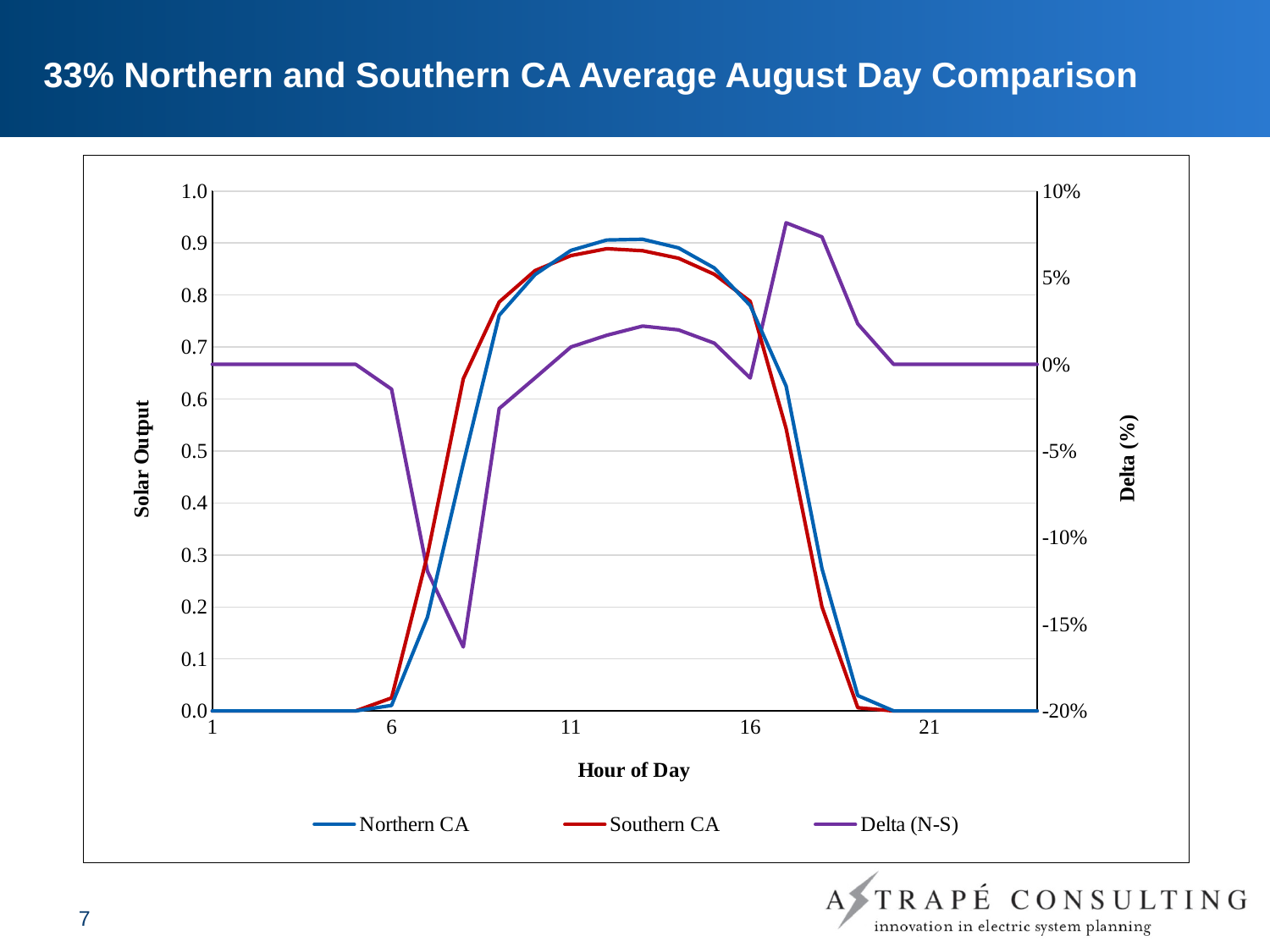
Is the Southern CA value at hour 6 greater or less than 0.1? less What is the label of the x axis? Hour of Day Does the Northern CA solar output rise or fall between hour 6 and hour 12? rise What are the three series named in the legend? Northern CA, Southern CA, Delta (N-S) Does the Southern CA solar output rise or fall between hour 14 and hour 19? fall How many series does the legend list? 3 Is the Delta (N-S) value at hour 17 greater or less than 5%? greater Is the Northern CA value at hour 12 greater or less than 0.8? greater At hour 8, which series has the higher solar output, Northern CA or Southern CA? Southern CA What kind of chart is shown on the slide? Line chart At hour 17, which series has the higher solar output, Northern CA or Southern CA? Northern CA